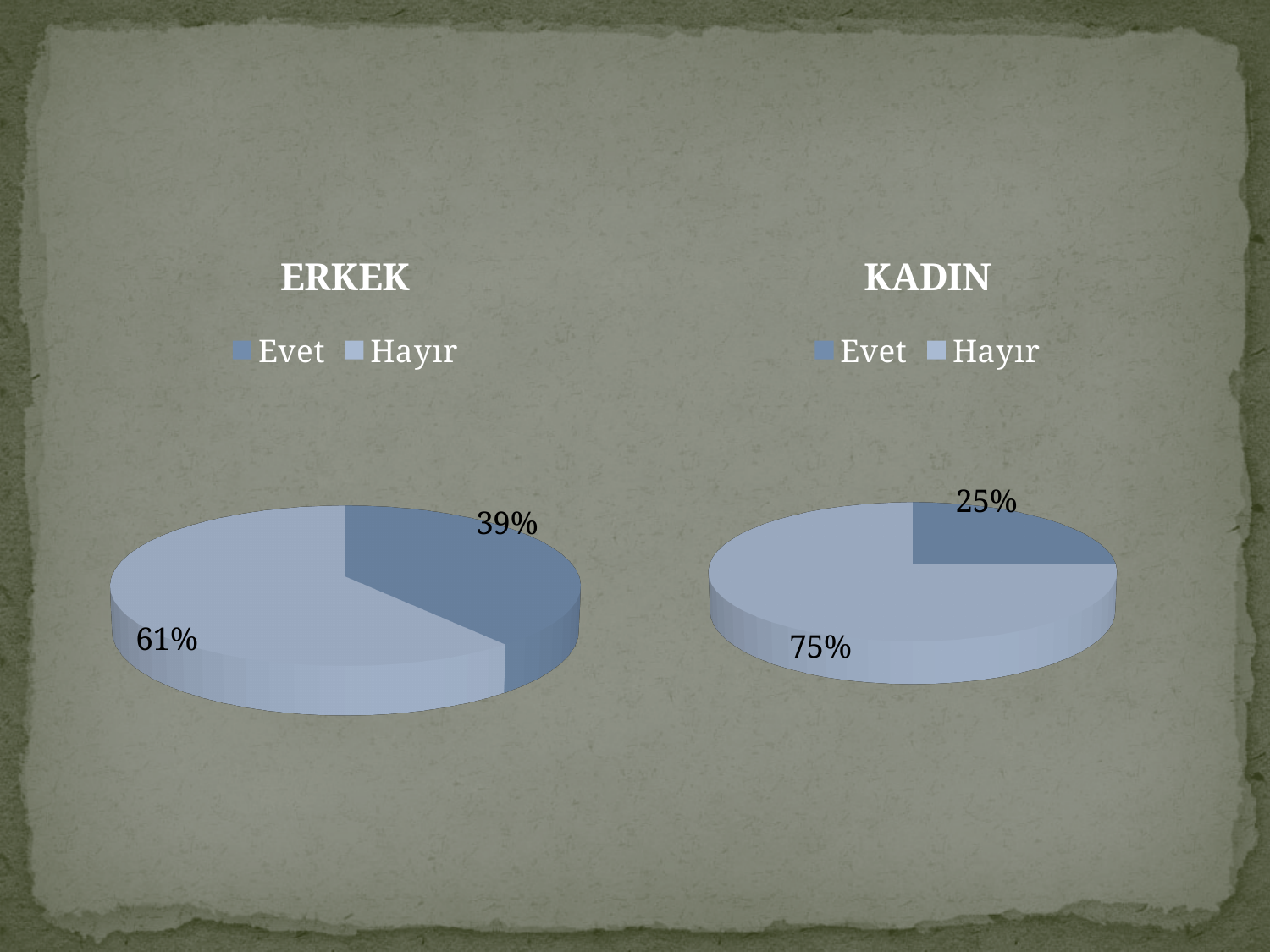
How many slices does the ERKEK chart have? 2 In the ERKEK chart, what share does Hayır have? 61% In the KADIN chart, what is the difference between the Hayır and Evet shares? 50% In the ERKEK chart, which slice is the largest? Hayır What entries does the legend of the KADIN chart list? Evet, Hayır In the KADIN chart, which slice is the smallest? Evet In the ERKEK chart, what is the difference between the Hayır and Evet shares? 22% In the ERKEK chart, what share does Evet have? 39% Which chart has the larger Evet share, ERKEK or KADIN? ERKEK In the KADIN chart, what share does Hayır have? 75% What kind of chart is the KADIN chart? Pie chart In the KADIN chart, what share does Evet have? 25%